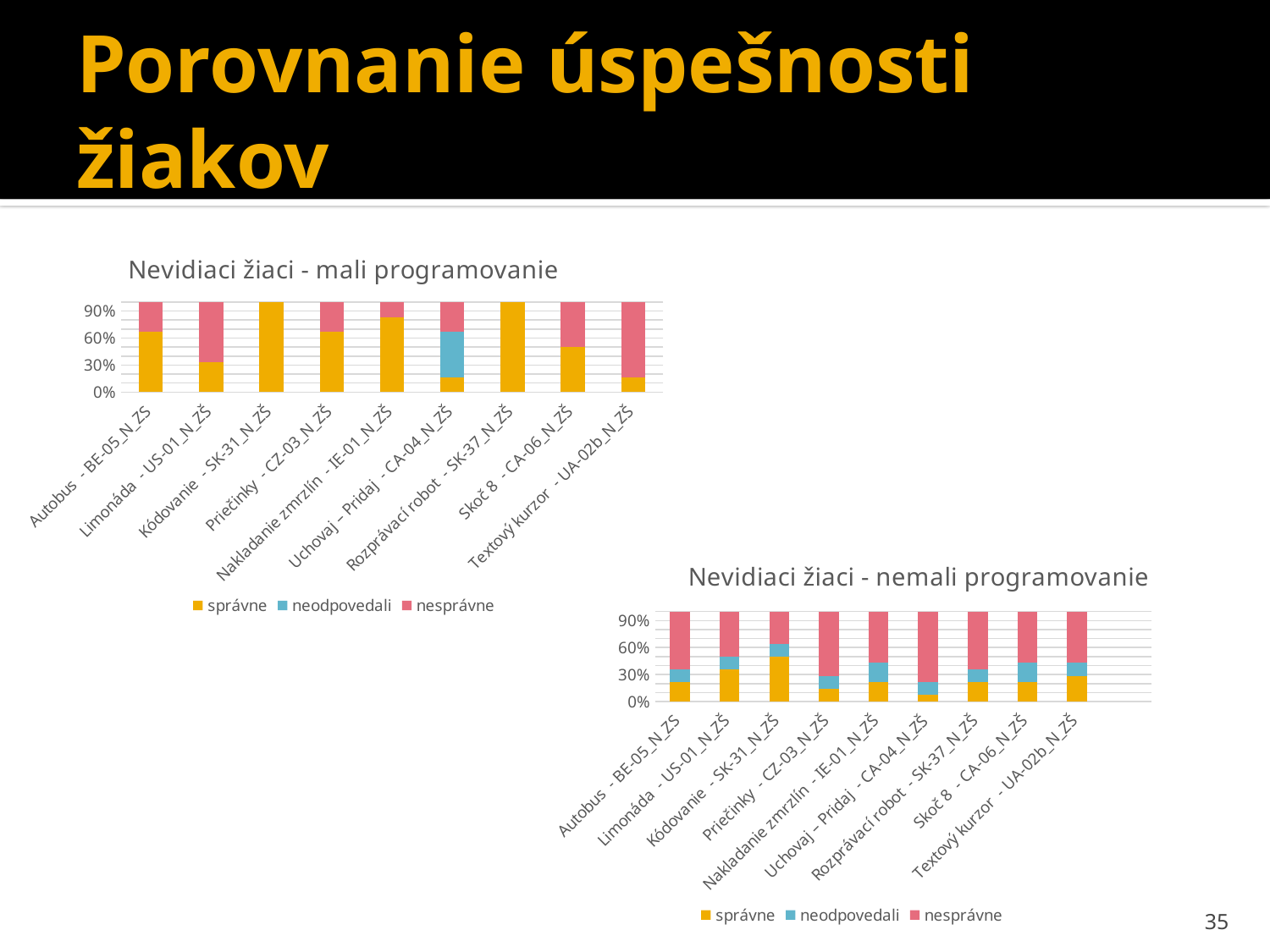
In the chart titled "Nevidiaci žiaci - mali programovanie", is the správne share for Textový kurzor - UA-02b_N_ZŠ greater or less than 30%? less In the chart titled "Nevidiaci žiaci - nemali programovanie", is the správne share for Uchovaj – Pridaj - CA-04_N_ZŠ greater or less than 30%? less In the chart titled "Nevidiaci žiaci - mali programovanie", which category has the largest neodpovedali share? Uchovaj – Pridaj - CA-04_N_ZŠ What are the legend entries of the chart titled "Nevidiaci žiaci - nemali programovanie"? správne, neodpovedali, nesprávne What kind of chart is the chart titled "Nevidiaci žiaci - mali programovanie"? stacked bar chart How many categories are shown on the x axis of the chart titled "Nevidiaci žiaci - nemali programovanie"? 9 How many series does the legend of the chart titled "Nevidiaci žiaci - mali programovanie" list? 3 What is the title of the chart in the lower right of the slide? Nevidiaci žiaci - nemali programovanie In the chart titled "Nevidiaci žiaci - nemali programovanie", is the správne share for Kódovanie - SK-31_N_ZŠ greater or less than 30%? greater In the chart titled "Nevidiaci žiaci - nemali programovanie", which category has the largest správne share? Kódovanie - SK-31_N_ZŠ In the chart titled "Nevidiaci žiaci - mali programovanie", which has the larger správne share: Limonáda - US-01_N_ZŠ or Kódovanie - SK-31_N_ZŠ? Kódovanie - SK-31_N_ZŠ